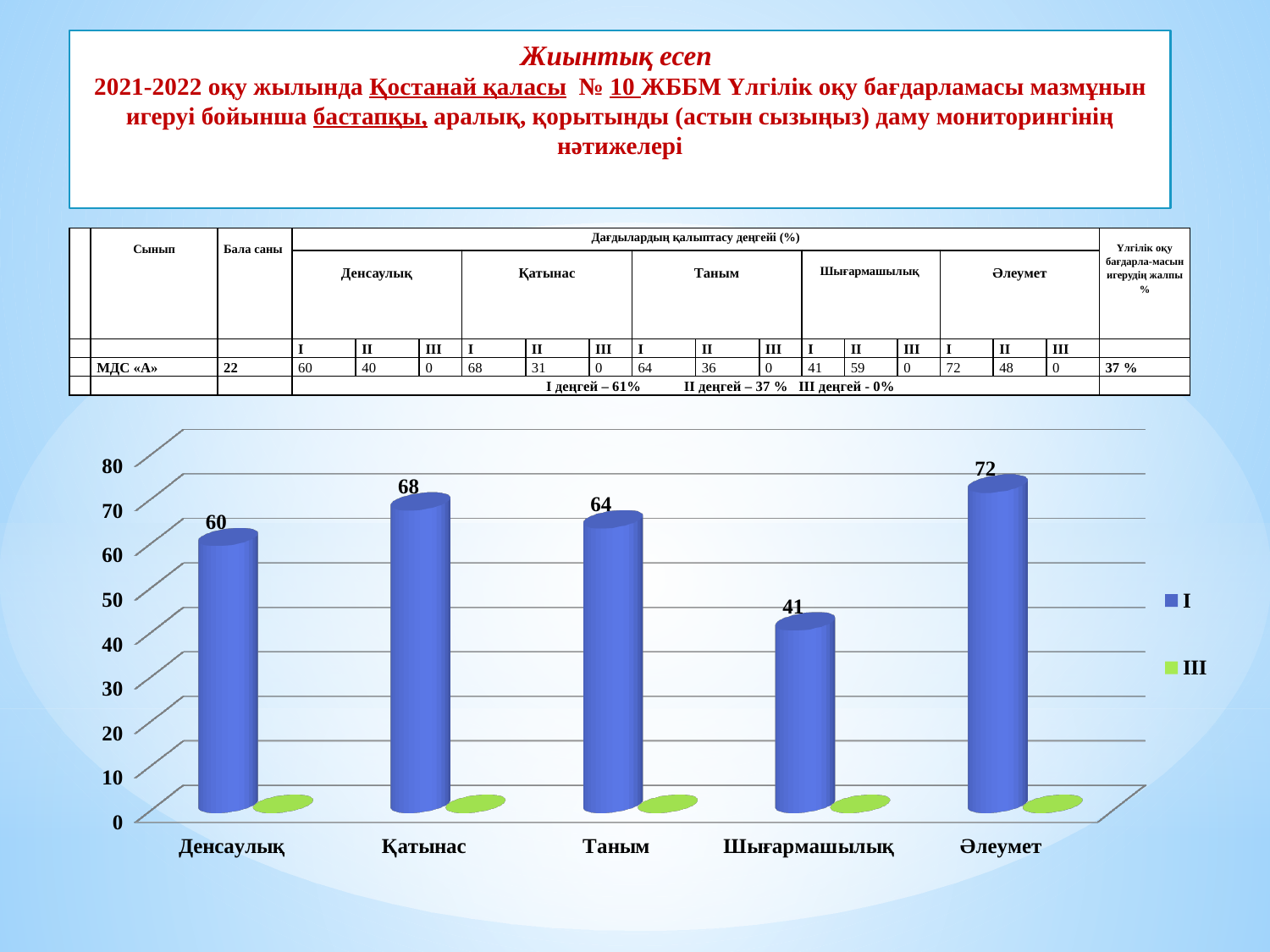
What is the value of series I for Қатынас? 68 Is the value of series I for Шығармашылық greater or less than 50? less How many series does the chart legend list? 2 What kind of chart is shown on the slide? bar chart Which is larger for series I: Денсаулық or Таным? Таным Which category has the highest value for series I? Әлеумет What is the value of series I for Шығармашылық? 41 What is the value of series I for Әлеумет? 72 What is the difference between the series I values for Әлеумет and Шығармашылық? 31 Which category has the lowest value for series I? Шығармашылық Which series is shown in green in the chart legend? III How many categories are shown on the x axis of the chart? 5